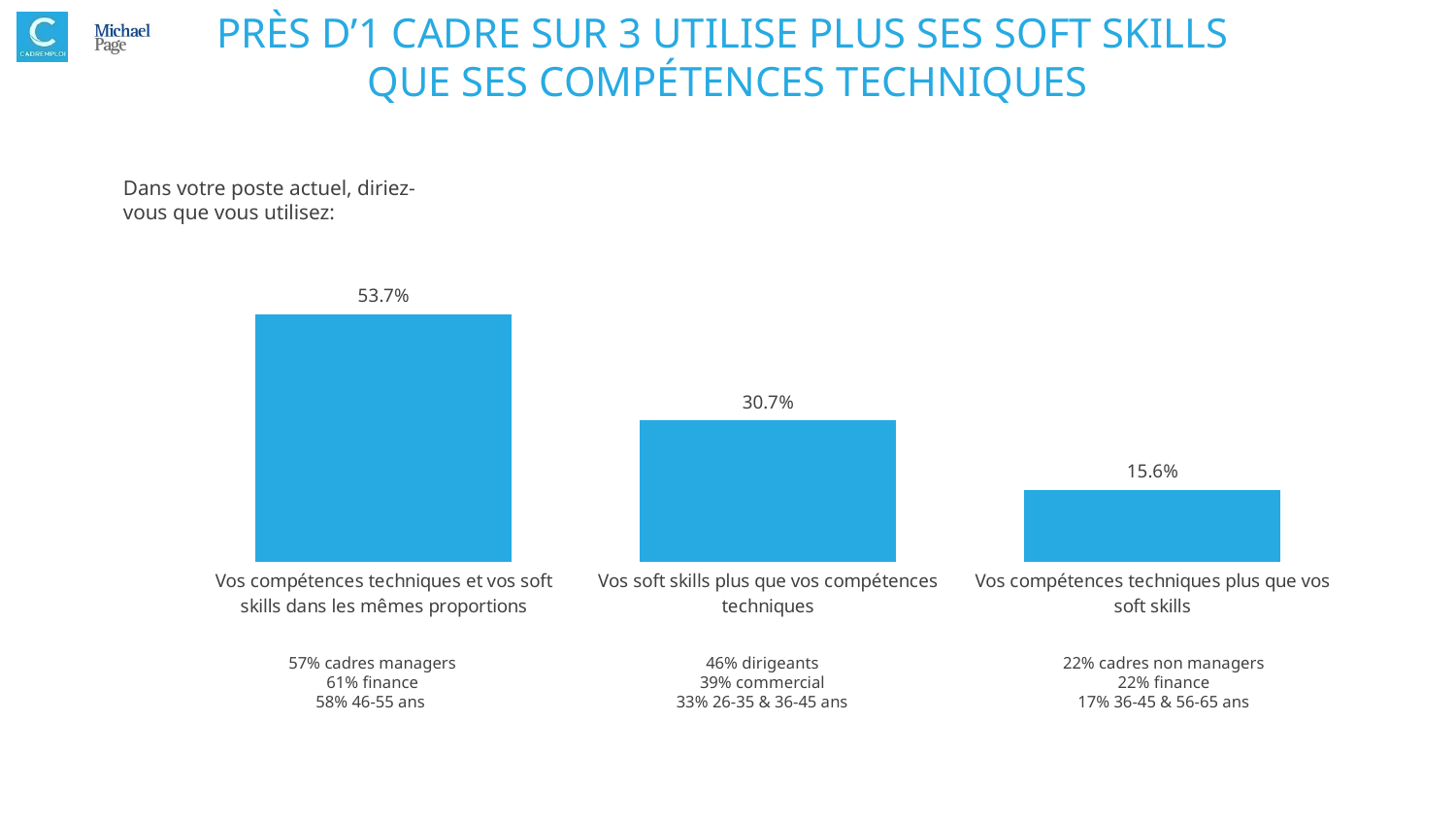
What is the value for "Vos soft skills plus que vos compétences techniques"? 30.7% Do the values rise or fall from left to right across the categories? Fall What question is the chart answering, as stated on the slide? Dans votre poste actuel, diriez-vous que vous utilisez: Which category has the highest value? Vos compétences techniques et vos soft skills dans les mêmes proportions What is the difference between the values for "Vos compétences techniques et vos soft skills dans les mêmes proportions" and "Vos soft skills plus que vos compétences techniques"? 23.0% What is the value for "Vos compétences techniques et vos soft skills dans les mêmes proportions"? 53.7% Which category has the lowest value? Vos compétences techniques plus que vos soft skills How many categories are shown in the chart? 3 What is the difference between the values for "Vos soft skills plus que vos compétences techniques" and "Vos compétences techniques plus que vos soft skills"? 15.1% What is the value for "Vos compétences techniques plus que vos soft skills"? 15.6% What kind of chart is shown on the slide? Bar chart Which is larger: the value for "Vos soft skills plus que vos compétences techniques" or for "Vos compétences techniques plus que vos soft skills"? Vos soft skills plus que vos compétences techniques